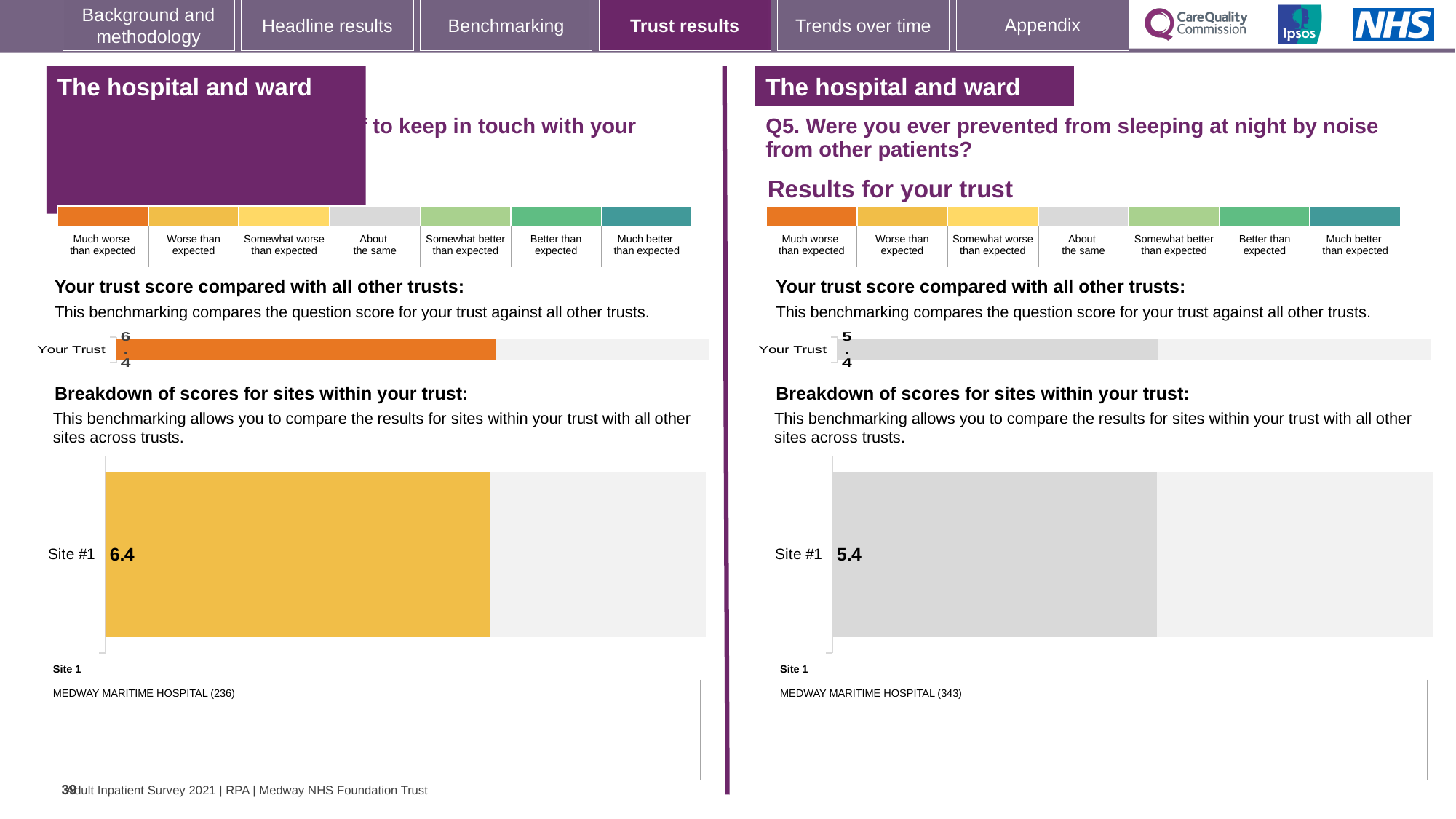
What kind of chart is used to show the Your Trust score on the left-hand side of the slide? Bar chart What kind of chart is used to show the Site #1 score on the right-hand side of the slide (Q5)? Bar chart On the right-hand side of the slide (Q5), which benchmark category does the grey colour of the Your Trust bar correspond to in the colour key? About the same Which is larger: the Your Trust score on the left-hand side of the slide or the Your Trust score on the right-hand side (Q5)? Left-hand side (6.4) On the right-hand side of the slide (Q5), what score is shown for Site #1 in the 'Breakdown of scores for sites within your trust' chart? 5.4 On the left-hand side of the slide, what is the score shown for Your Trust in the 'Your trust score compared with all other trusts' chart? 6.4 How many sites are shown in the 'Breakdown of scores for sites within your trust' chart on the right-hand side of the slide (Q5)? 1 On the left-hand side of the slide, what score is shown for Site #1 in the 'Breakdown of scores for sites within your trust' chart? 6.4 What is the difference between the Site #1 score on the left-hand side of the slide (6.4) and the Site #1 score on the right-hand side (5.4)? 1.0 On the left-hand side of the slide, which benchmark category does the orange colour of the Your Trust bar correspond to in the colour key? Much worse than expected On the right-hand side of the slide (Q5, prevented from sleeping at night by noise from other patients), what is the score shown for Your Trust in the 'Your trust score compared with all other trusts' chart? 5.4 How many sites are shown in the 'Breakdown of scores for sites within your trust' chart on the left-hand side of the slide? 1